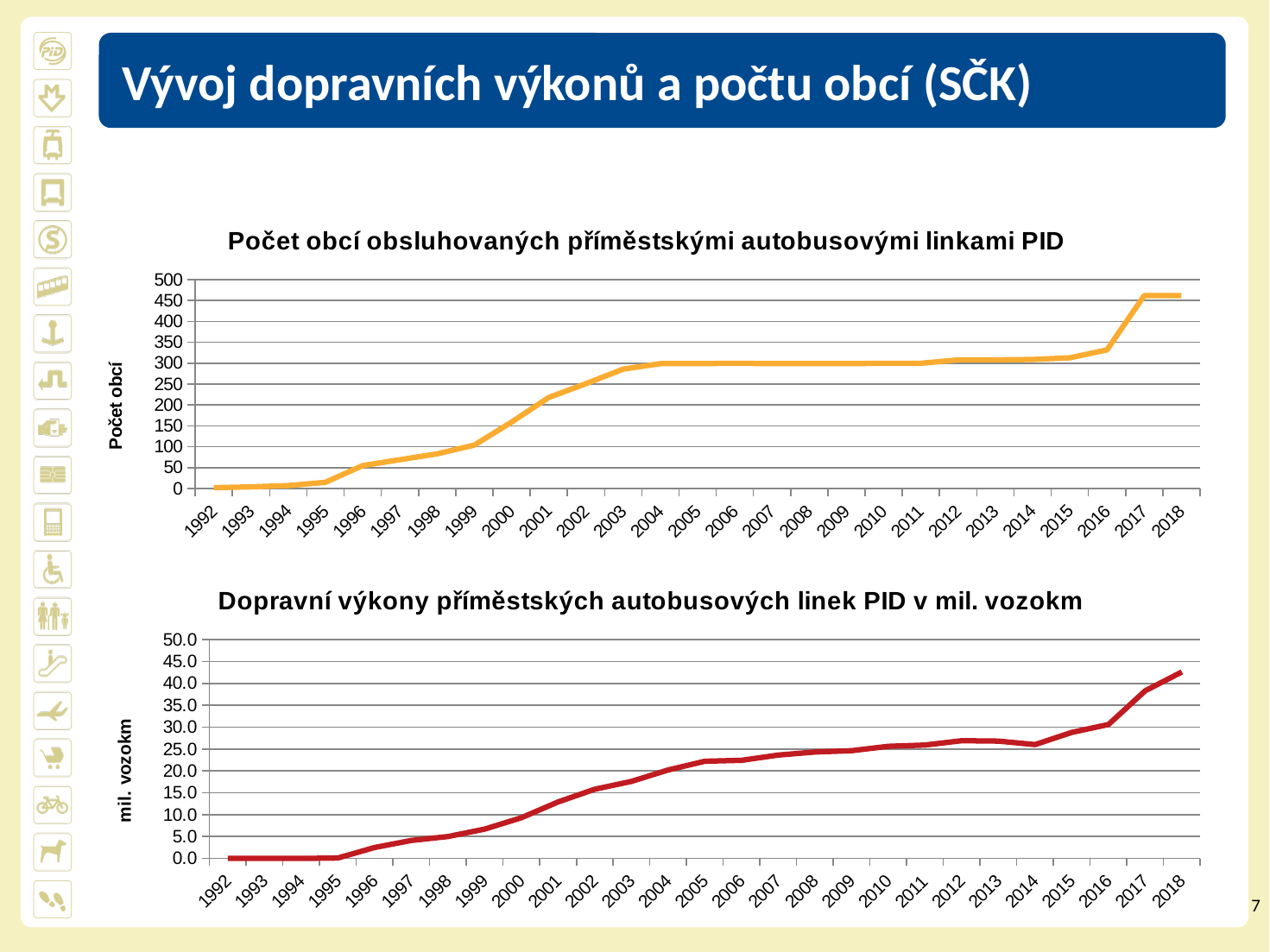
In the bottom chart, is the value for 2018 greater or less than 40.0? greater How many years are plotted on the x axis of the top chart? 27 What kind of chart is the top chart, 'Počet obcí obsluhovaných příměstskými autobusovými linkami PID'? line chart In the top chart, which year has the larger value, 2000 or 2010? 2010 In the top chart, is the value for 2001 greater or less than 200? greater In the top chart, is the value for 2018 greater or less than 450? greater In the bottom chart, which year has the highest value? 2018 What is the y-axis label of the bottom chart? mil. vozokm What kind of chart is the bottom chart, 'Dopravní výkony příměstských autobusových linek PID v mil. vozokm'? line chart In the bottom chart, do the values generally rise or fall from 1992 to 2018? rise